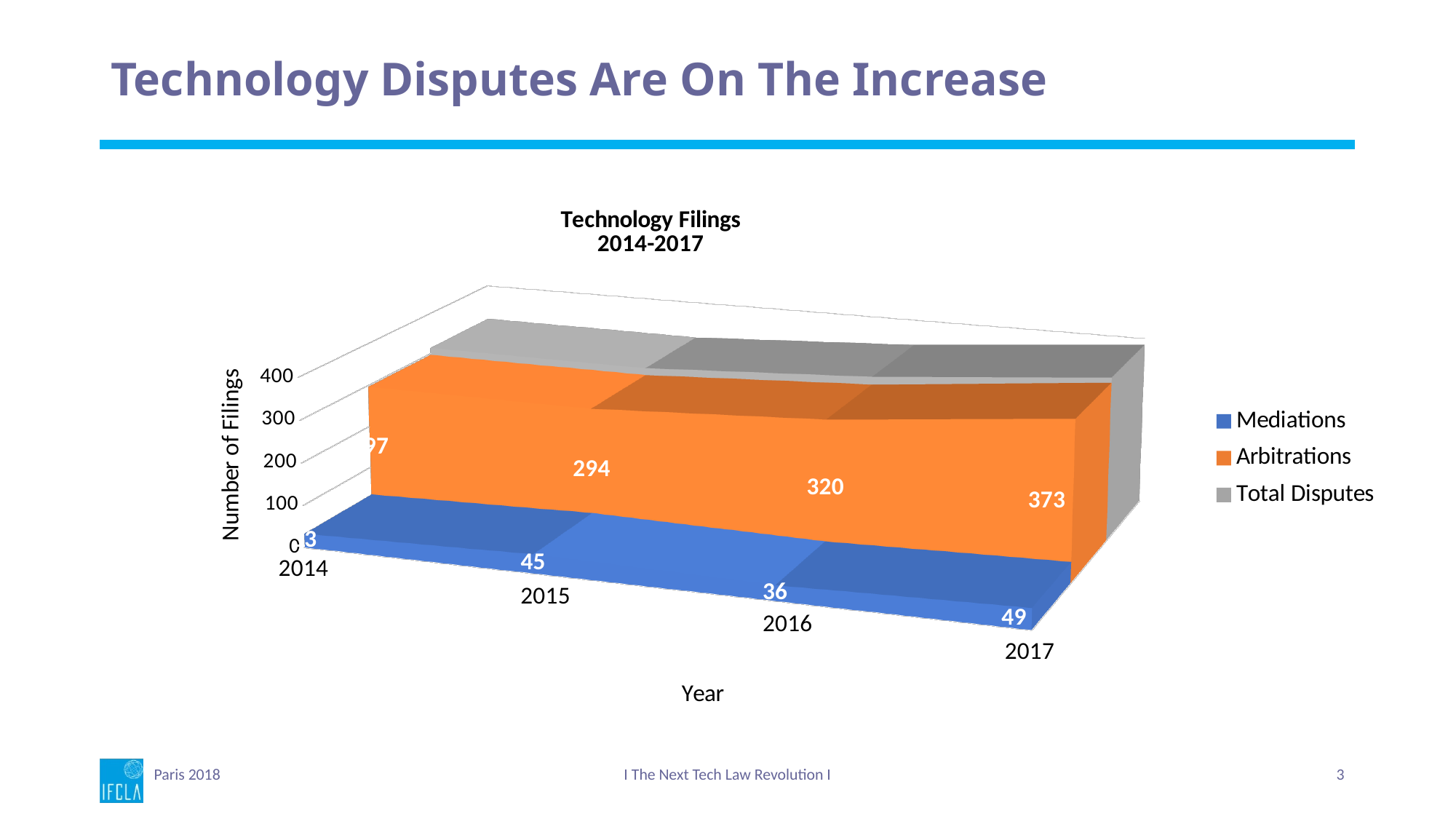
Is the value for Arbitrations in 2016 greater or less than 300? greater What is the value for Arbitrations in 2017? 373 How many years are shown on the x axis? 4 What is the title of the chart? Technology Filings 2014-2017 Which is larger, Mediations in 2015 or Mediations in 2016? Mediations in 2015 What type of chart is shown on the slide? area chart What is the value for Mediations in 2017? 49 What is the value for Mediations in 2016? 36 How many series does the legend list? 3 What is the difference between Arbitrations in 2017 and Arbitrations in 2016? 53 What is the value for Arbitrations in 2015? 294 Do the Arbitrations values rise or fall from 2015 to 2017? rise